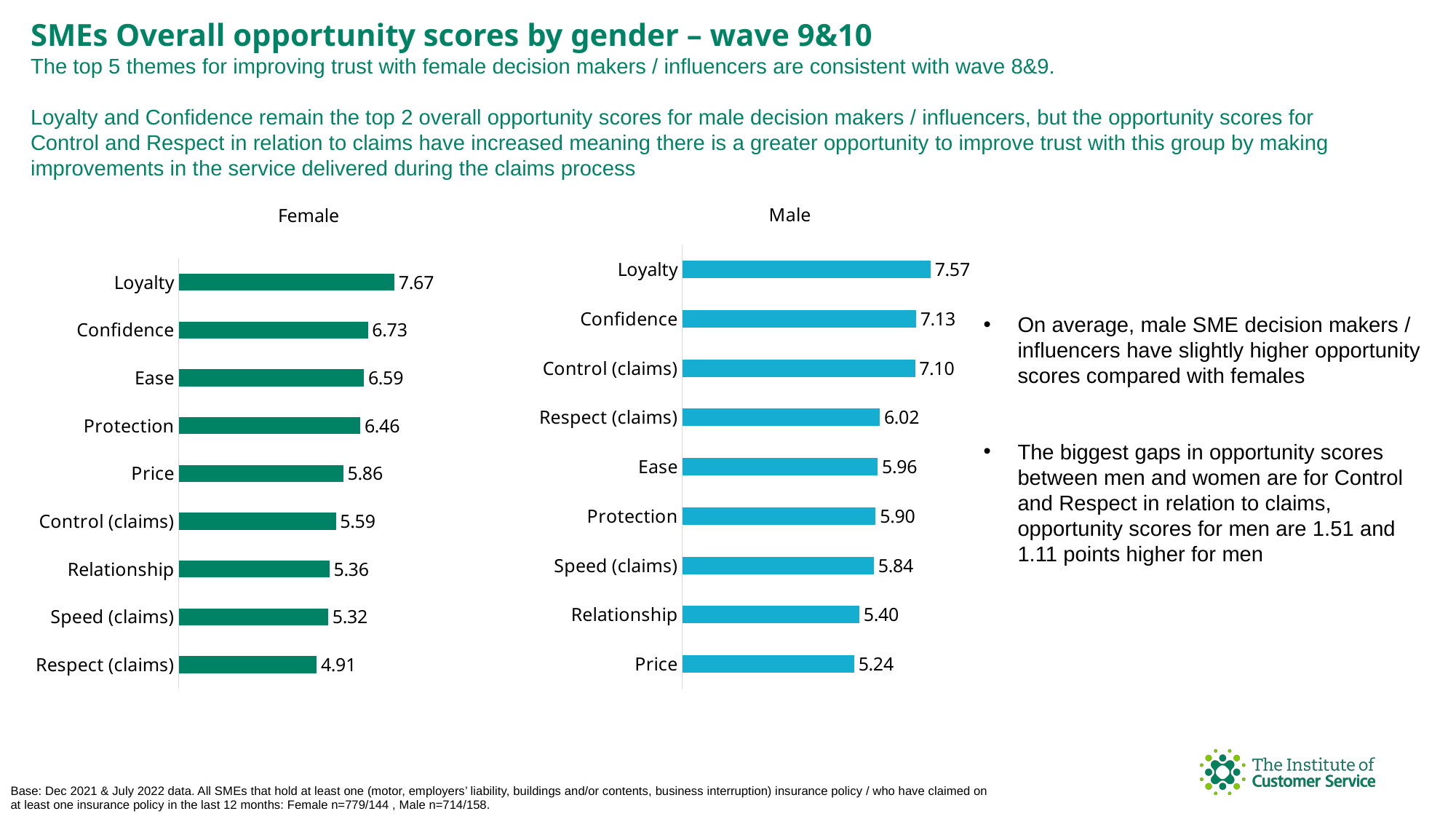
In the Male chart, what is the opportunity score for Control (claims)? 7.10 What is the difference between the Male and Female scores for Respect (claims)? 1.11 What is the difference between the Male and Female scores for Control (claims)? 1.51 What type of chart is the Male chart? Bar chart How many categories are shown in the Female chart? 9 In the Female chart, what is the opportunity score for Loyalty? 7.67 In the Male chart, which category has the lowest score? Price In the Male chart, which category has the highest score? Loyalty Which is larger: the Female score for Price or the Male score for Price? Female score for Price In the Female chart, what is the score for Speed (claims)? 5.32 What colour are the bars in the Male chart? Light blue In the Female chart, which category has the lowest score? Respect (claims)